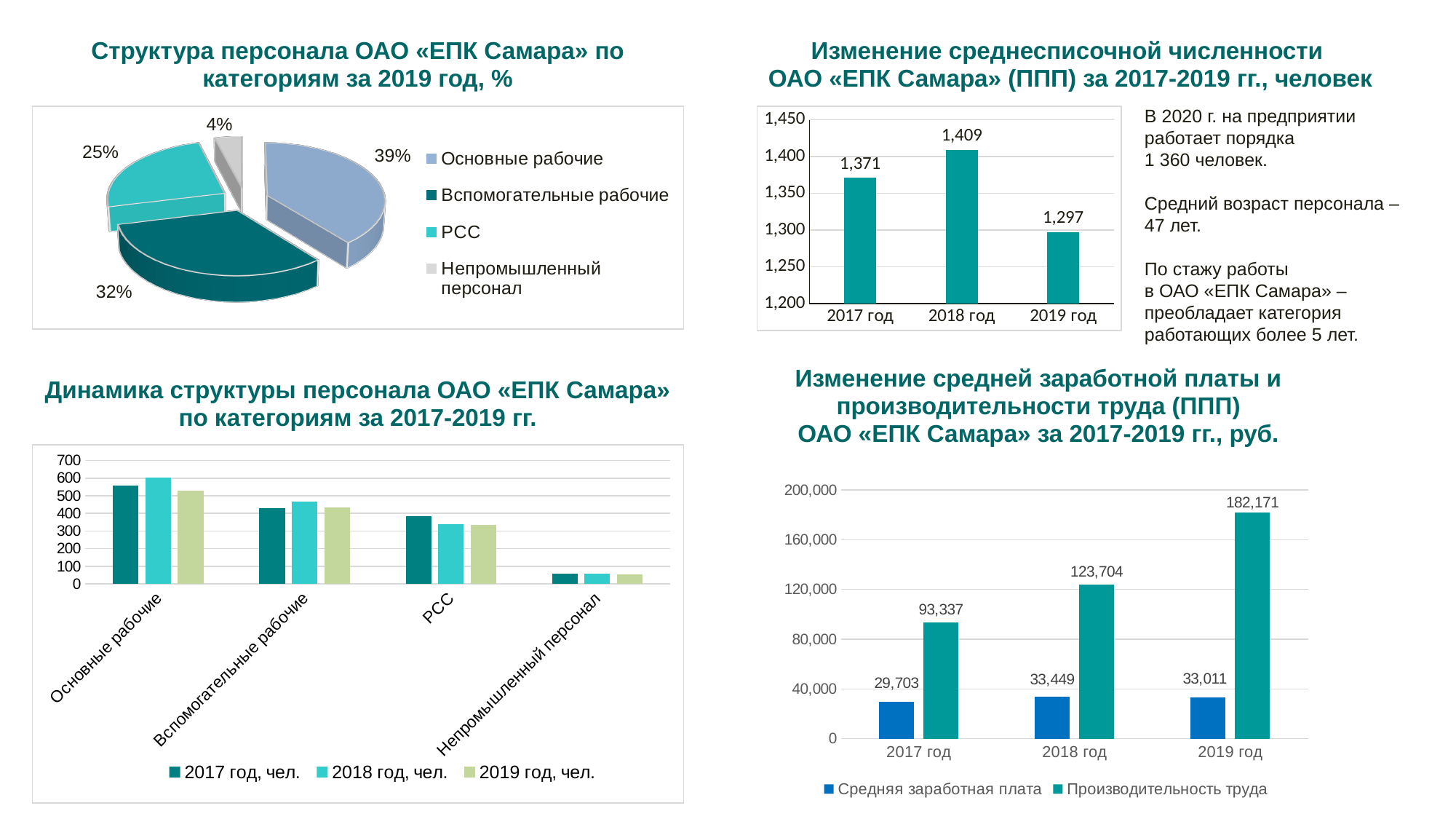
In the chart 'Изменение среднесписочной численности ОАО «ЕПК Самара» (ППП) за 2017-2019 гг., человек', which year has the lowest value? 2019 год In the chart 'Изменение среднесписочной численности ОАО «ЕПК Самара» (ППП) за 2017-2019 гг., человек', what is the difference between the 2018 год and 2019 год values? 112 In the chart 'Изменение среднесписочной численности ОАО «ЕПК Самара» (ППП) за 2017-2019 гг., человек', what is the value for 2018 год? 1,409 In the chart 'Динамика структуры персонала ОАО «ЕПК Самара» по категориям за 2017-2019 гг.', is the value for Основные рабочие in 2018 год greater or less than 500? greater In the chart 'Динамика структуры персонала ОАО «ЕПК Самара» по категориям за 2017-2019 гг.', how many series does the legend list? 3 In the pie chart 'Структура персонала ОАО «ЕПК Самара» по категориям за 2019 год, %', which category has the smallest share? Непромышленный персонал In the chart 'Изменение средней заработной платы и производительности труда (ППП) ОАО «ЕПК Самара» за 2017-2019 гг., руб.', does Производительность труда rise or fall from 2017 год to 2019 год? rise In the chart 'Динамика структуры персонала ОАО «ЕПК Самара» по категориям за 2017-2019 гг.', what kind of chart is shown? bar chart In the chart 'Изменение средней заработной платы и производительности труда (ППП) ОАО «ЕПК Самара» за 2017-2019 гг., руб.', what is the value of Производительность труда for 2019 год? 182,171 In the pie chart 'Структура персонала ОАО «ЕПК Самара» по категориям за 2019 год, %', how many categories does the legend list? 4 In the pie chart 'Структура персонала ОАО «ЕПК Самара» по категориям за 2019 год, %', what share is shown for Основные рабочие? 39% In the chart 'Изменение средней заработной платы и производительности труда (ППП) ОАО «ЕПК Самара» за 2017-2019 гг., руб.', which year has the highest Средняя заработная плата? 2018 год